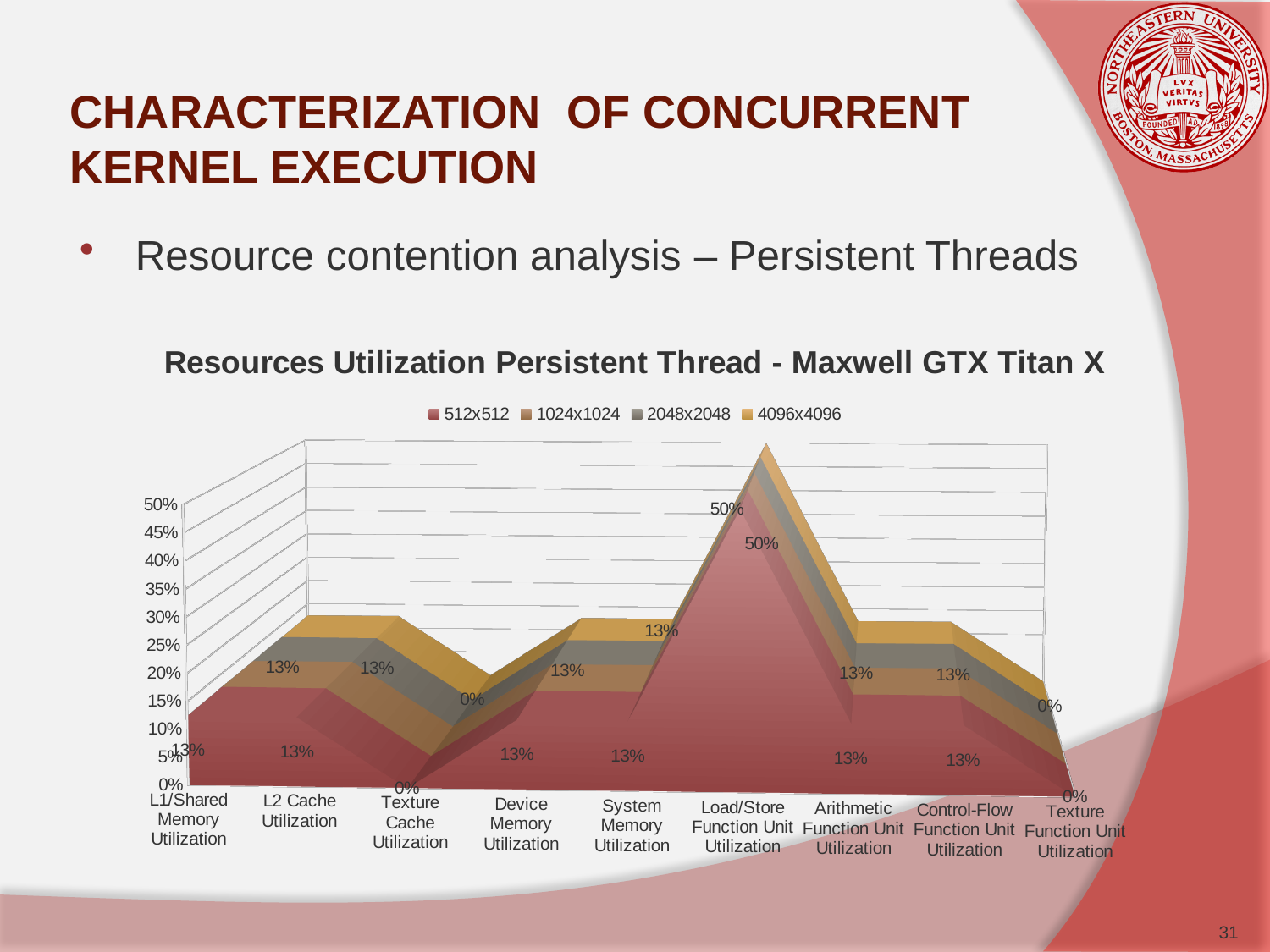
What utilization value is labeled for Texture Cache Utilization? 0% Which resource category has the highest utilization in the chart? Load/Store Function Unit Utilization What type of chart is shown on the slide? Area chart Is the utilization for Load/Store Function Unit Utilization greater or less than 40%? greater What utilization value is labeled for Load/Store Function Unit Utilization? 50% What utilization value is labeled for L2 Cache Utilization? 13% What is the difference between the labeled utilization for Load/Store Function Unit Utilization (50%) and Control-Flow Function Unit Utilization (13%)? 37% Which is larger, the utilization for Load/Store Function Unit Utilization or for Arithmetic Function Unit Utilization? Load/Store Function Unit Utilization How many series does the chart legend list? 4 What is the title of the chart? Resources Utilization Persistent Thread - Maxwell GTX Titan X How many resource categories are shown along the x axis of the chart? 9 Which series is listed first in the chart legend? 512x512